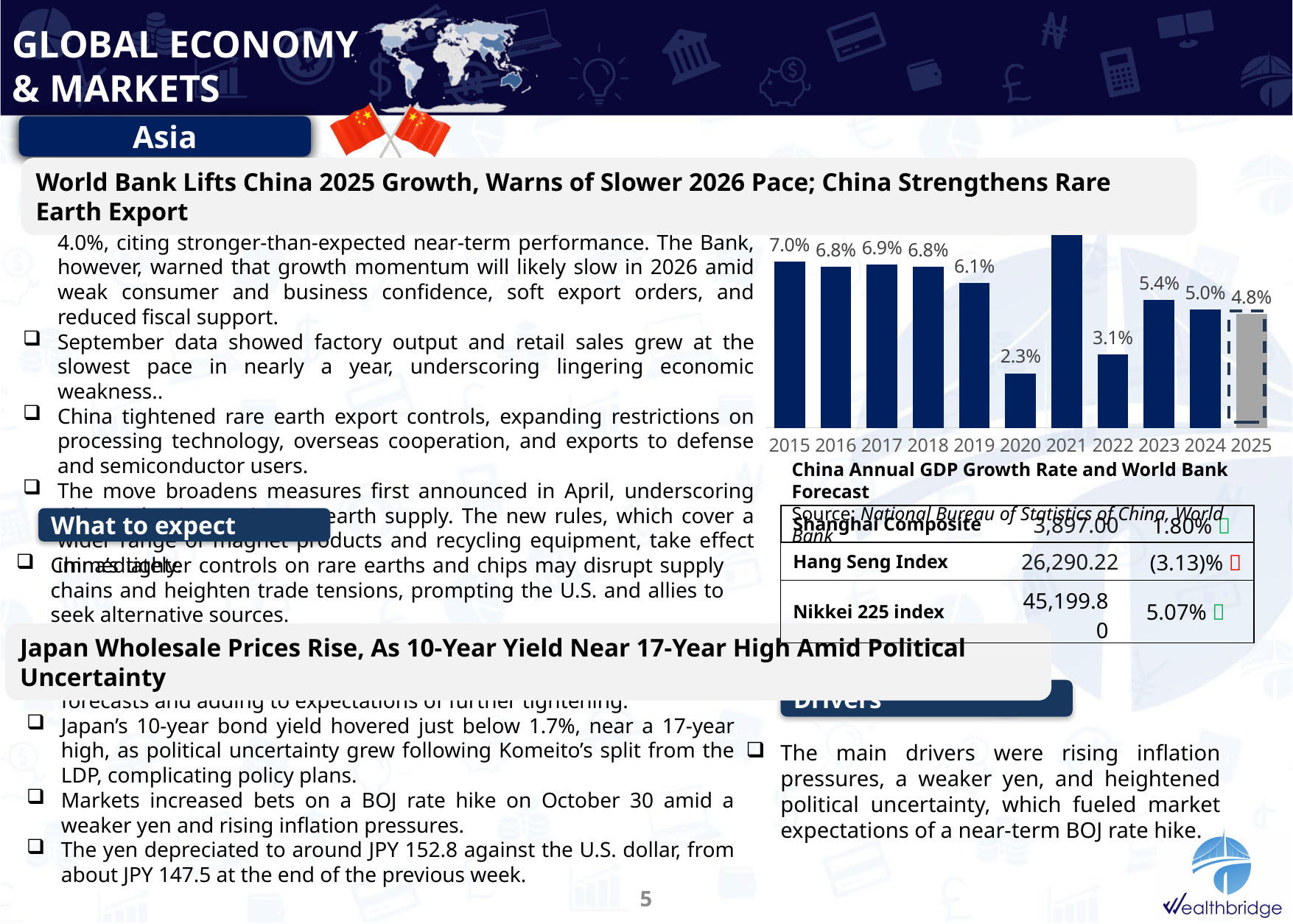
Do the GDP growth values fall or rise from 2015 to 2020? fall What is the GDP growth rate shown for 2020? 2.3% Which year has a higher GDP growth rate, 2017 or 2024? 2017 What is China's GDP growth rate for 2015 in the chart? 7.0% Which year has the tallest bar in the China GDP growth chart? 2021 Which year has the lowest GDP growth rate in the chart? 2020 What is the title of the bar chart on the slide? China Annual GDP Growth Rate and World Bank Forecast What is the GDP growth rate shown for 2023? 5.4% What is the World Bank forecast value shown for 2025? 4.8% How many years are shown on the x axis of the China GDP growth chart? 11 What is the difference between the GDP growth rates for 2019 and 2022? 3.0% What type of chart is used to show China's annual GDP growth rate? bar chart